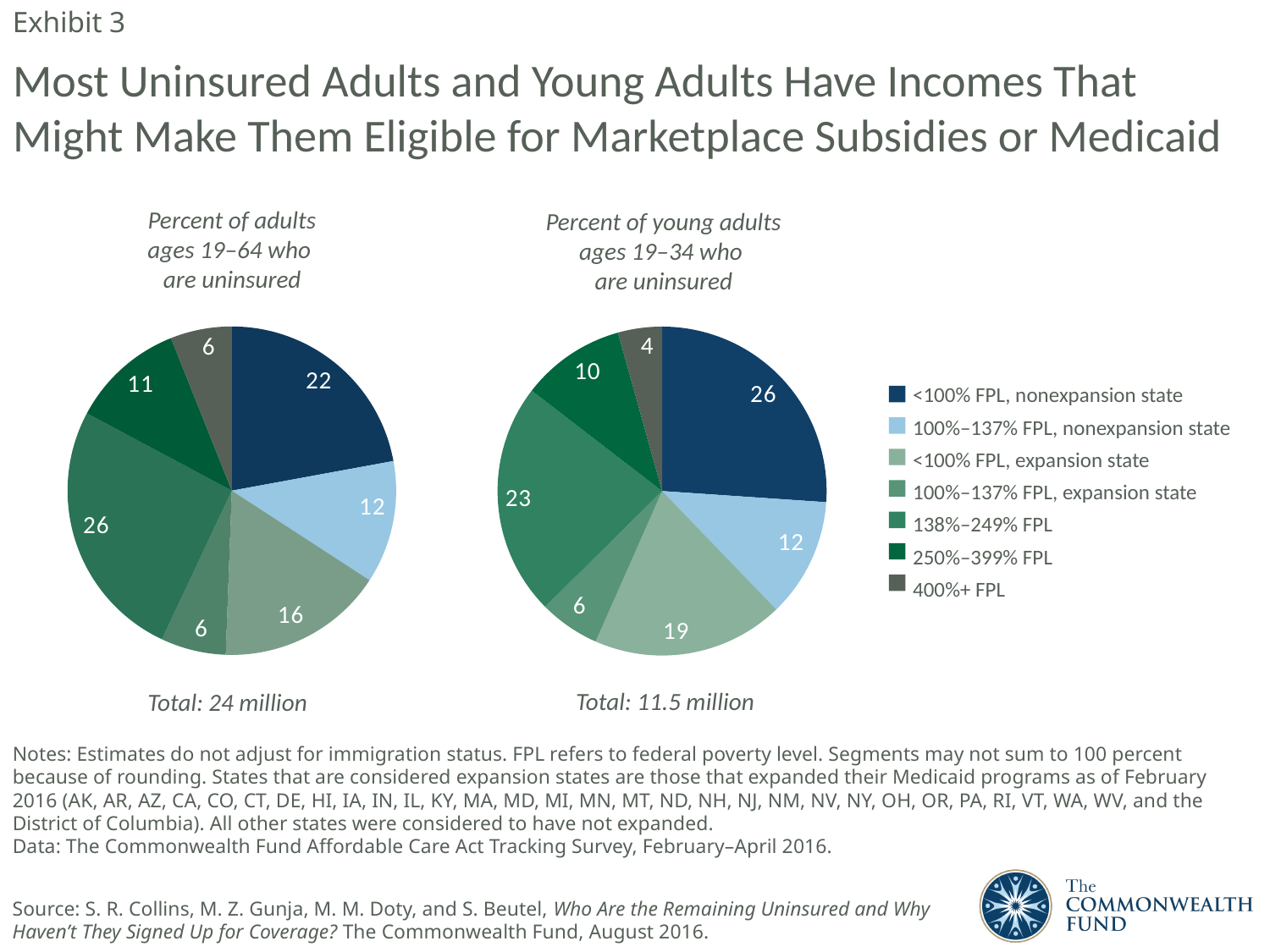
What total is shown beneath the left pie chart (adults ages 19–64)? Total: 24 million In the right pie chart (young adults ages 19–34), what percent are in the 138%–249% FPL category? 23 In the right pie chart (young adults ages 19–34), which category has the smallest share? 400%+ FPL How many categories does the legend list for the pie charts? 7 What total is shown beneath the right pie chart (young adults ages 19–34)? Total: 11.5 million In the left pie chart (adults ages 19–64), which category has the largest share? 138%–249% FPL In the right pie chart (young adults ages 19–34), what percent are in the 250%–399% FPL category? 10 What type of charts are shown on the slide? Pie charts In the left pie chart (adults ages 19–64), what percent are in the <100% FPL, nonexpansion state category? 22 In the left pie chart (adults ages 19–64), what percent are in the <100% FPL, expansion state category? 16 In the right pie chart (young adults ages 19–34), what is the difference between the <100% FPL, nonexpansion state share and the 100%–137% FPL, nonexpansion state share? 14 Which is larger in the left pie chart (adults ages 19–64): the 250%–399% FPL share or the 400%+ FPL share? 250%–399% FPL